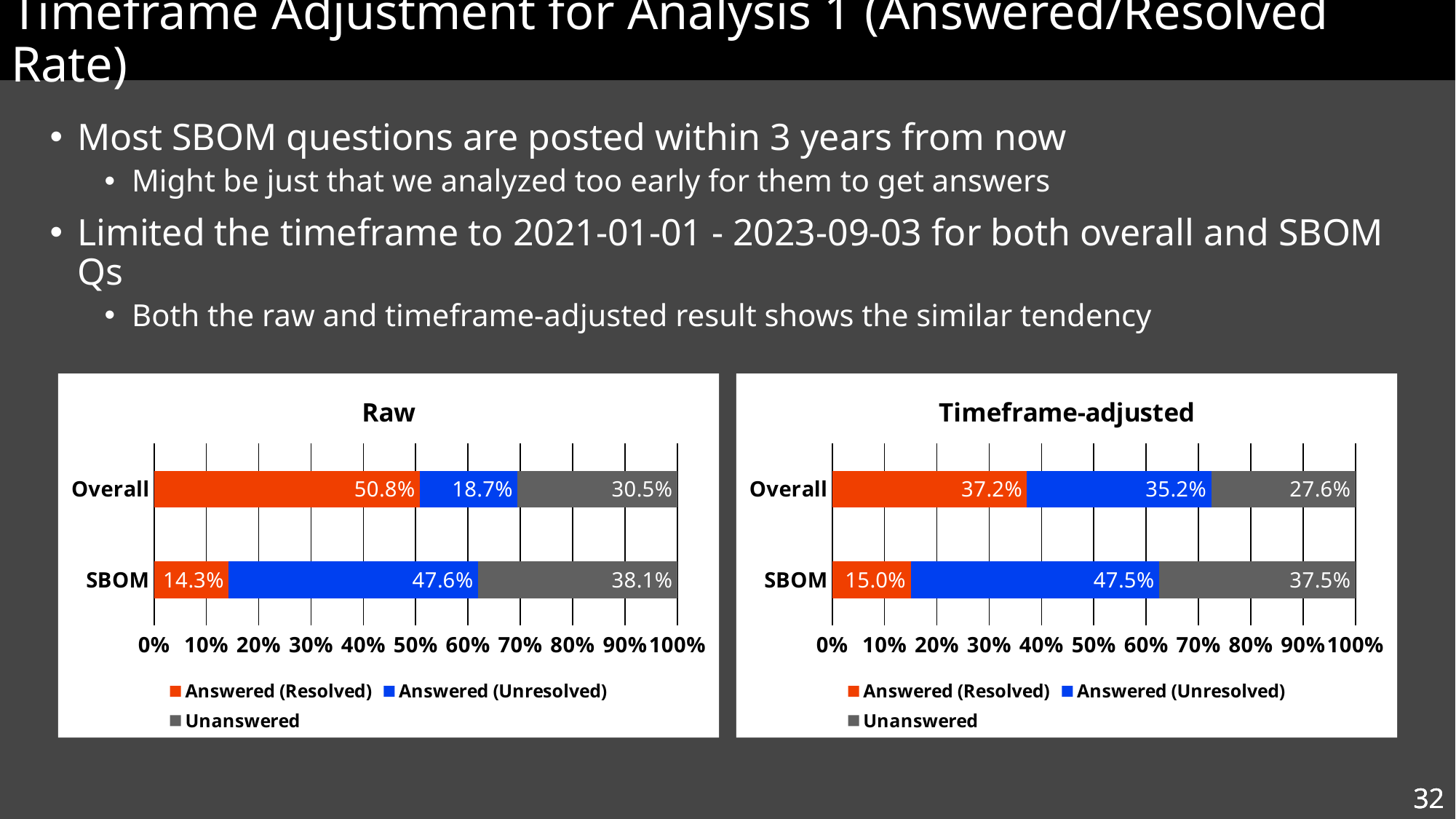
In the Timeframe-adjusted chart, what is the Answered (Resolved) value for Overall? 37.2% In the Raw chart, what is the Answered (Resolved) value for Overall? 50.8% In the Timeframe-adjusted chart, what is the Answered (Unresolved) value for SBOM? 47.5% How many series does the legend of the Raw chart list? 3 What kind of chart is the Raw chart? Stacked bar chart In the Timeframe-adjusted chart, what is the difference between the Unanswered values for SBOM and Overall? 9.9% In the Raw chart, which series has the highest value for SBOM? Answered (Unresolved) In the Timeframe-adjusted chart, which category has the larger Unanswered value, Overall or SBOM? SBOM In the Timeframe-adjusted chart, which series has the lowest value for SBOM? Answered (Resolved) In the Raw chart, what is the Unanswered value for SBOM? 38.1% In the Raw chart, what is the difference between the Answered (Resolved) values for Overall and SBOM? 36.5% How many categories are shown in the Timeframe-adjusted chart? 2